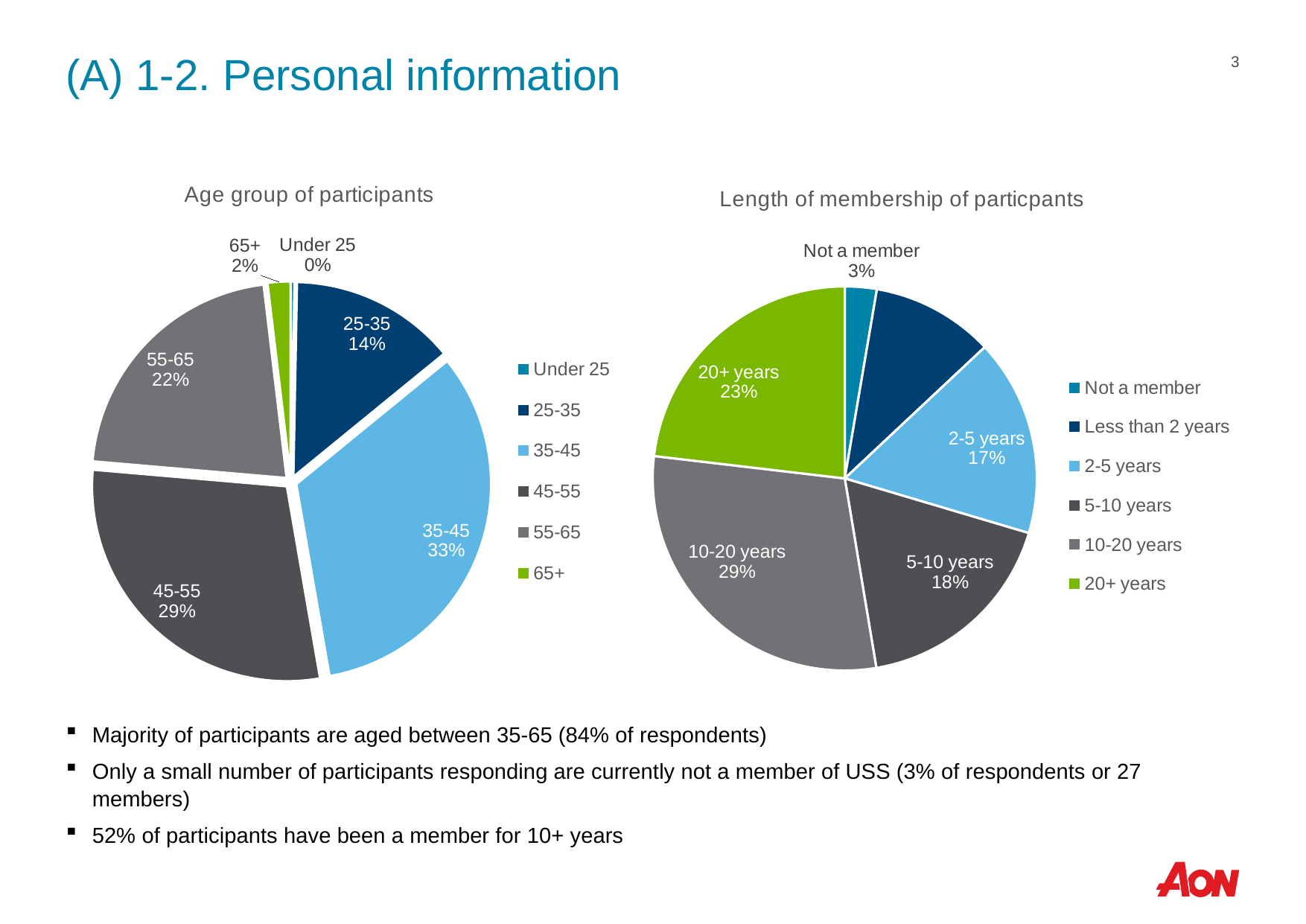
In the 'Length of membership of particpants' chart, what colour is the 20+ years slice? Green In the 'Length of membership of particpants' chart, what percentage of participants are not a member? 3% In the 'Age group of participants' chart, what is the difference in percentage points between the 45-55 and 25-35 groups? 15 In the 'Age group of participants' chart, which age group has the smallest share? Under 25 In the 'Age group of participants' chart, how many age groups does the legend list? 6 In the 'Age group of participants' chart, what percentage of participants are aged 35-45? 33% In the 'Length of membership of particpants' chart, what percentage of participants have been members for 10-20 years? 29% In the 'Age group of participants' chart, which age group has the largest share? 35-45 What type of chart is used for 'Length of membership of particpants'? Pie chart In the 'Age group of participants' chart, what percentage of participants are aged 55-65? 22% In the 'Length of membership of particpants' chart, which is larger: the share for 10-20 years or for 20+ years? 10-20 years In the 'Length of membership of particpants' chart, which category has the largest share? 10-20 years